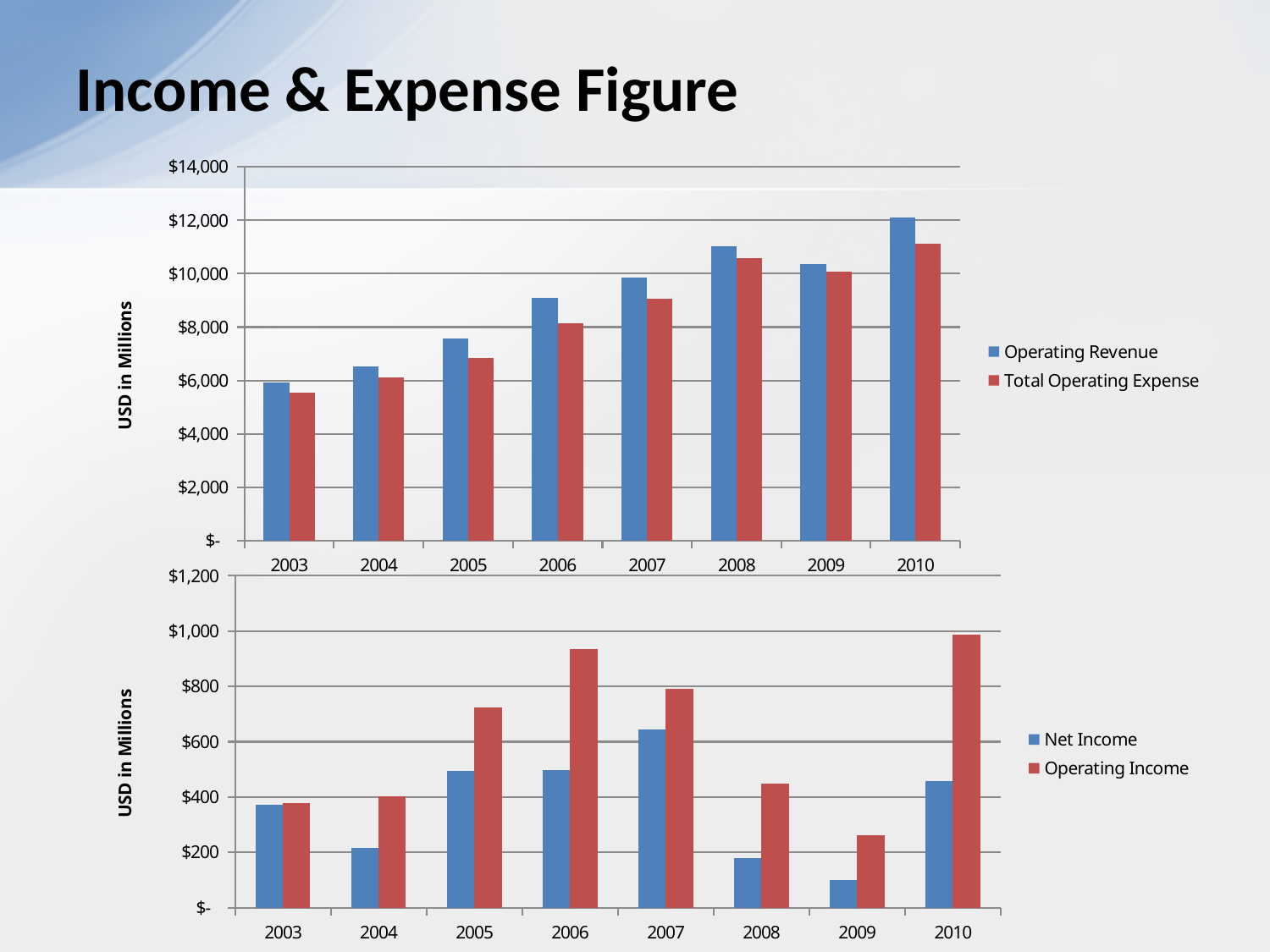
In the top chart, is the Operating Revenue for 2005 greater or less than $8,000? less In the top chart, is the Operating Revenue for 2008 greater or less than $10,000? greater How many series does the legend of the top chart list? 2 In the top chart, which year has the highest Operating Revenue? 2010 What is the y-axis label of the bottom chart? USD in Millions What kind of chart is the top chart on the slide? bar chart In the bottom chart, is the Operating Income for 2006 greater or less than $800? greater In the bottom chart, which year has the lowest Net Income? 2009 How many years are shown on the x axis of the bottom chart? 8 In the top chart, which is larger in 2006: Operating Revenue or Total Operating Expense? Operating Revenue In the bottom chart, which year has the highest Operating Income? 2010 In the top chart, which year has the lowest Total Operating Expense? 2003